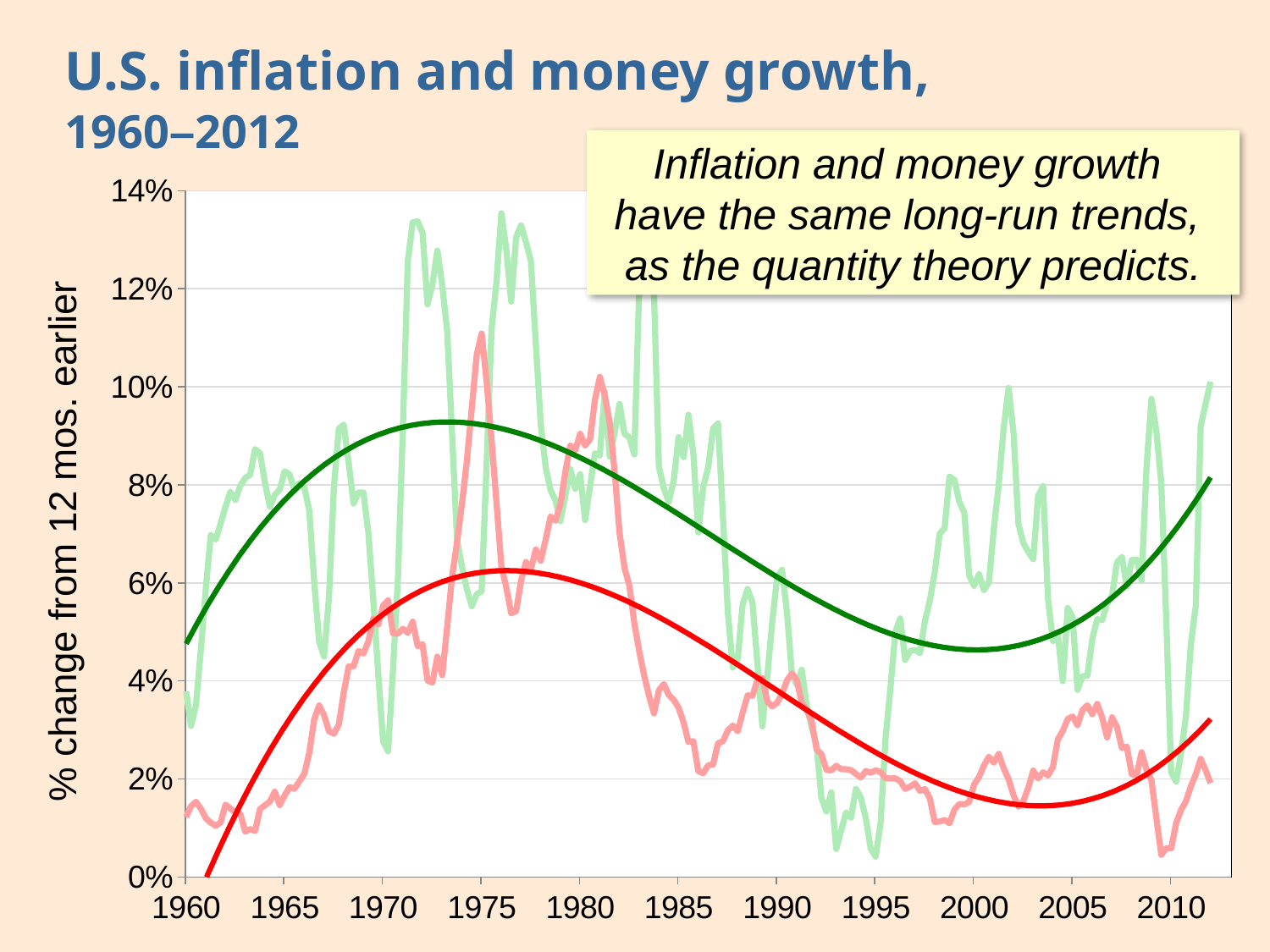
What kind of chart is shown on the slide? line chart What is the label on the vertical axis of the chart? % change from 12 mos. earlier What is the last year labeled on the horizontal axis of the chart? 2010 Is the lowest point of the red smooth trend line, around 2003, greater or less than 2%? less What is the first year labeled on the horizontal axis of the chart? 1960 How many year labels are shown on the horizontal axis of the chart? 11 Is the peak of the dark green smooth trend line, around 1973, greater or less than 8%? greater Does the red smooth trend line rise or fall between 1977 and 2003? fall What is the title of the chart on the slide? U.S. inflation and money growth, 1960–2012 What is the highest value shown on the vertical axis of the chart? 14% Does the dark green smooth trend line rise or fall between 1960 and 1973? rise Is the lowest point of the dark green smooth trend line, around 2000, greater or less than 6%? less